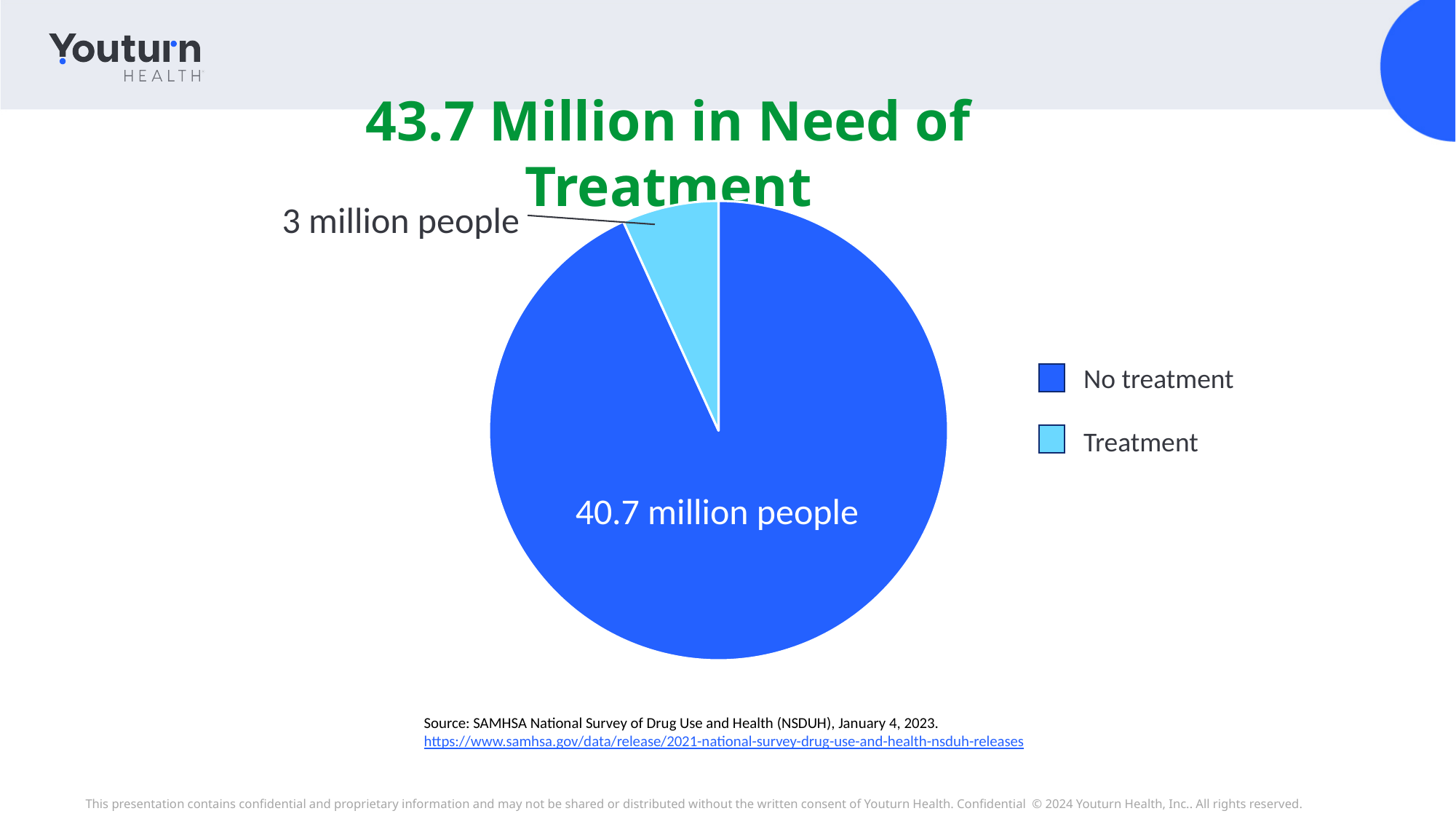
Which slice is the smallest? Treatment Which is larger, the No treatment slice or the Treatment slice? No treatment What is the value for the Treatment slice? 3 million people What colour is the Treatment slice? light blue What is the value for the No treatment slice? 40.7 million people What is the title of the chart? 43.7 Million in Need of Treatment How many slices does the pie chart have? 2 Which slice is the largest? No treatment What kind of chart is shown on the slide? pie chart What is the total of the two slices in millions of people? 43.7 million How many entries does the legend list? 2 What is the difference in millions of people between the No treatment and Treatment slices? 37.7 million people